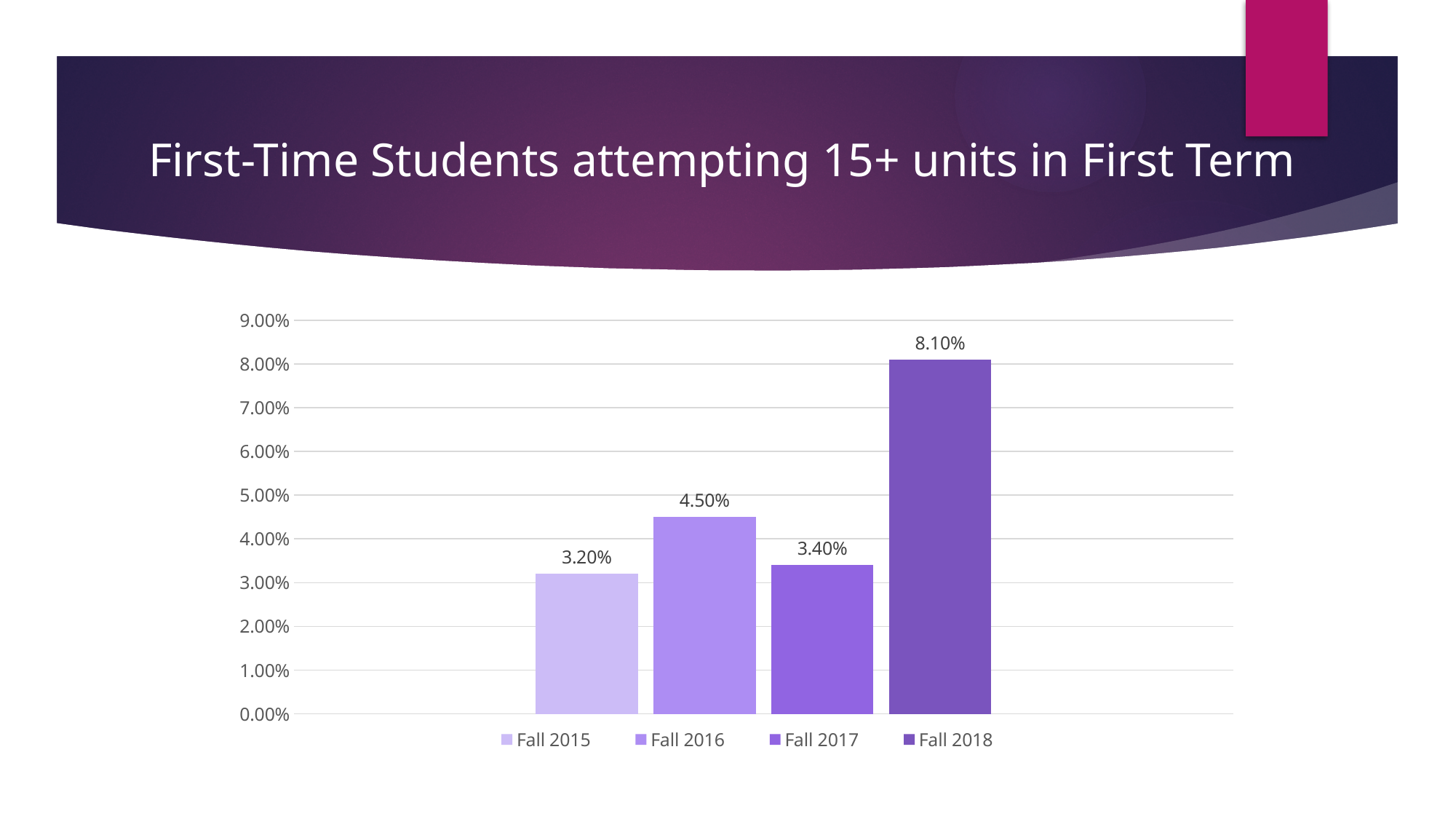
What is the value for Fall 2015? 3.20% Which is larger, the value for Fall 2016 or the value for Fall 2017? Fall 2016 Which term has the lowest value? Fall 2015 How many bars are shown in the chart? 4 What kind of chart is shown on the slide? bar chart What is the value for Fall 2016? 4.50% What is the title of the slide? First-Time Students attempting 15+ units in First Term What is the value for Fall 2017? 3.40% Which term has the highest value? Fall 2018 What is the value for Fall 2018? 8.10% Is the value for Fall 2018 greater or less than 7.00%? greater What is the difference between the values for Fall 2018 and Fall 2016? 3.60%